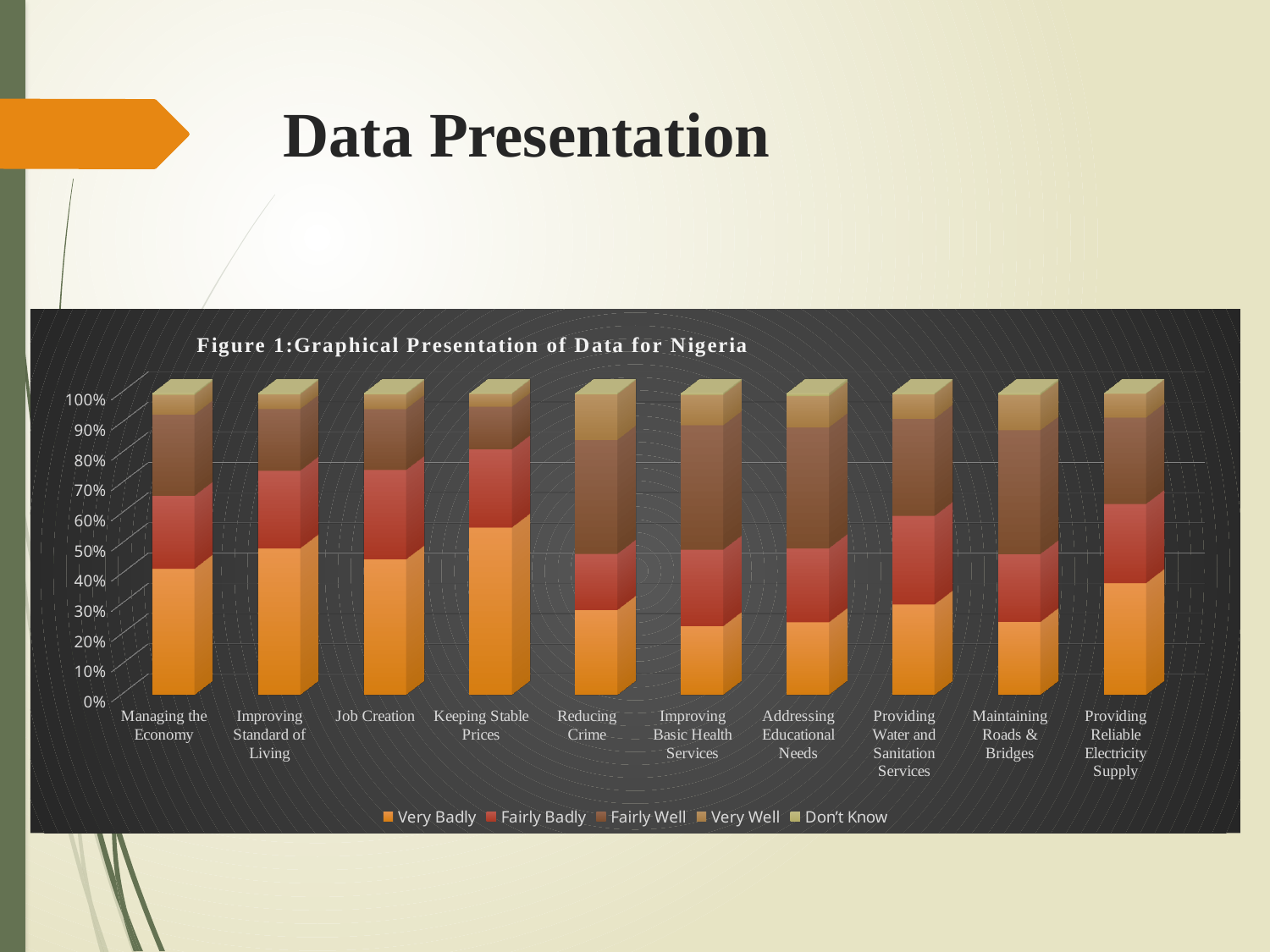
Which has the larger Very Badly value, Improving Standard of Living or Addressing Educational Needs? Improving Standard of Living How many categories are shown along the x axis of the chart? 10 Which category has the highest Very Badly value? Keeping Stable Prices Is the Very Badly value for Keeping Stable Prices greater or less than 50%? greater What is the title of the chart? Figure 1:Graphical Presentation of Data for Nigeria What kind of chart is shown on the slide? bar chart Is the Very Badly value for Managing the Economy greater or less than 30%? greater How many series does the chart's legend list? 5 Is the Very Badly value for Reducing Crime greater or less than 40%? less Which has the larger Very Badly value, Job Creation or Reducing Crime? Job Creation Which series is listed first in the chart's legend? Very Badly